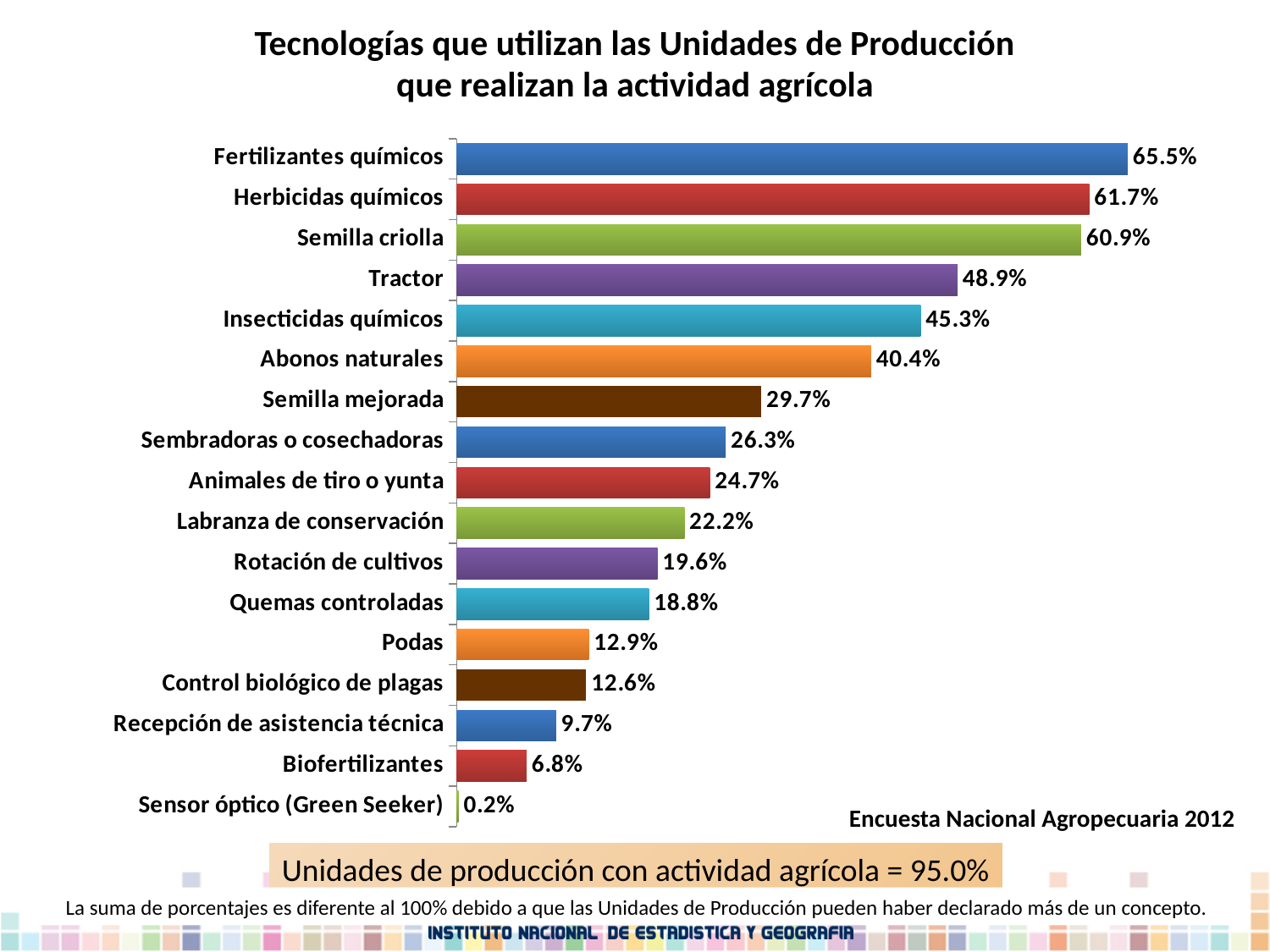
Do the values increase or decrease going from the top bar to the bottom bar? Decrease What is the value for Semilla mejorada? 29.7% Which technology has the lowest percentage? Sensor óptico (Green Seeker) Which is larger, the value for Tractor or the value for Abonos naturales? Tractor How many technologies are listed in the chart? 17 What percentage is shown for Sensor óptico (Green Seeker)? 0.2% What kind of chart is shown on the slide? Bar chart What percentage of production units use Fertilizantes químicos? 65.5% What is the difference in percentage points between Fertilizantes químicos and Herbicidas químicos? 3.8 What is the value shown for Tractor? 48.9% What is the difference in percentage points between Podas and Control biológico de plagas? 0.3 Which technology has the highest percentage? Fertilizantes químicos